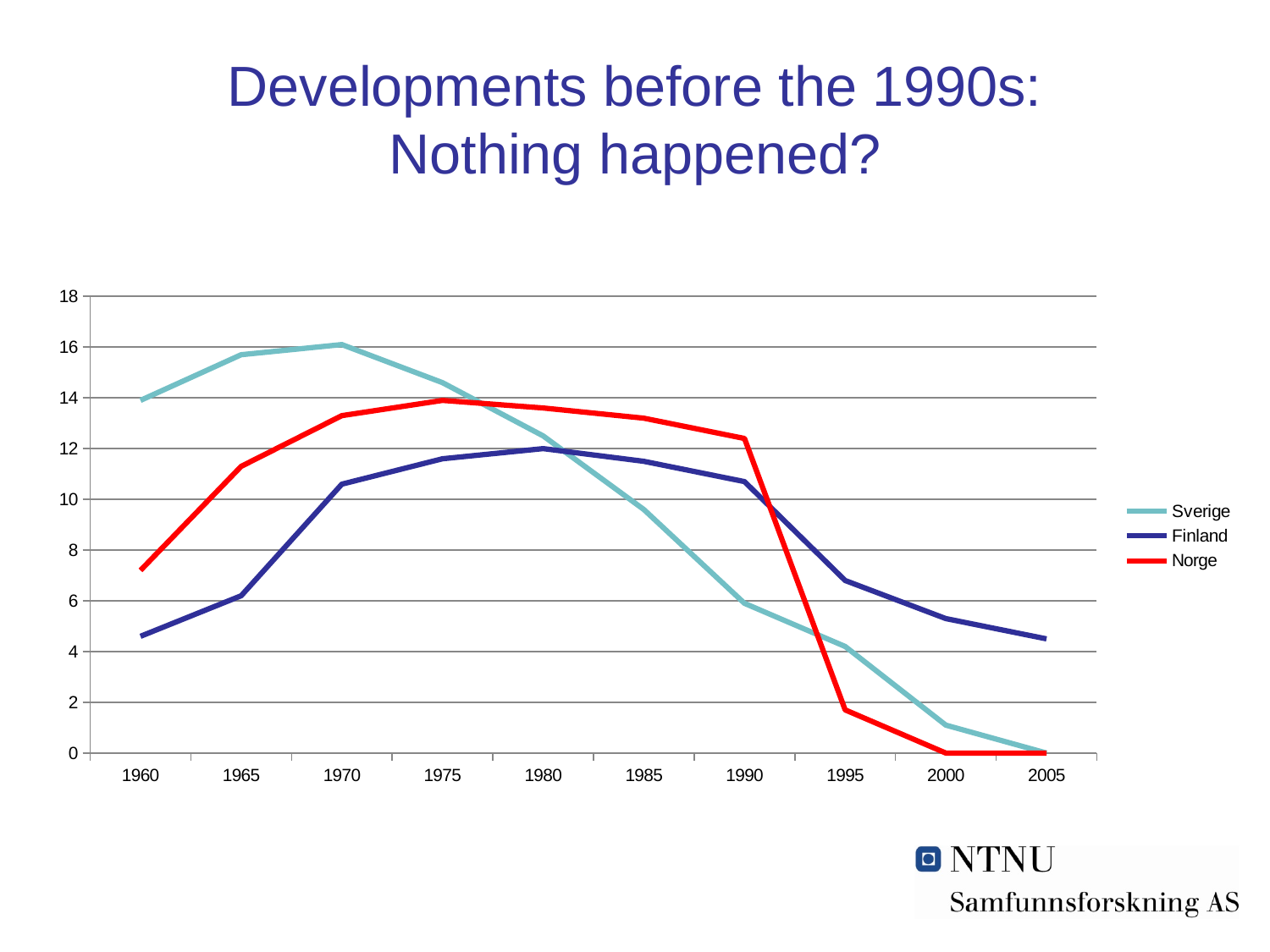
What colour is the Norge line in the chart? red In 2005, which is larger: the value for Finland or the value for Sverige? Finland Does the Sverige line rise or fall from 1970 to 2005? fall How many series does the legend list? 3 Which series has the lowest value in 1960? Finland Which series has the highest value in 1970? Sverige How many years are marked along the x axis? 10 Is the value for Norge in 1995 greater or less than 4? less In 1960, which is larger: the value for Sverige or the value for Finland? Sverige Is the value for Sverige in 1970 greater or less than 14? greater Is the value for Finland in 1960 greater or less than 6? less What kind of chart is shown on the slide? line chart